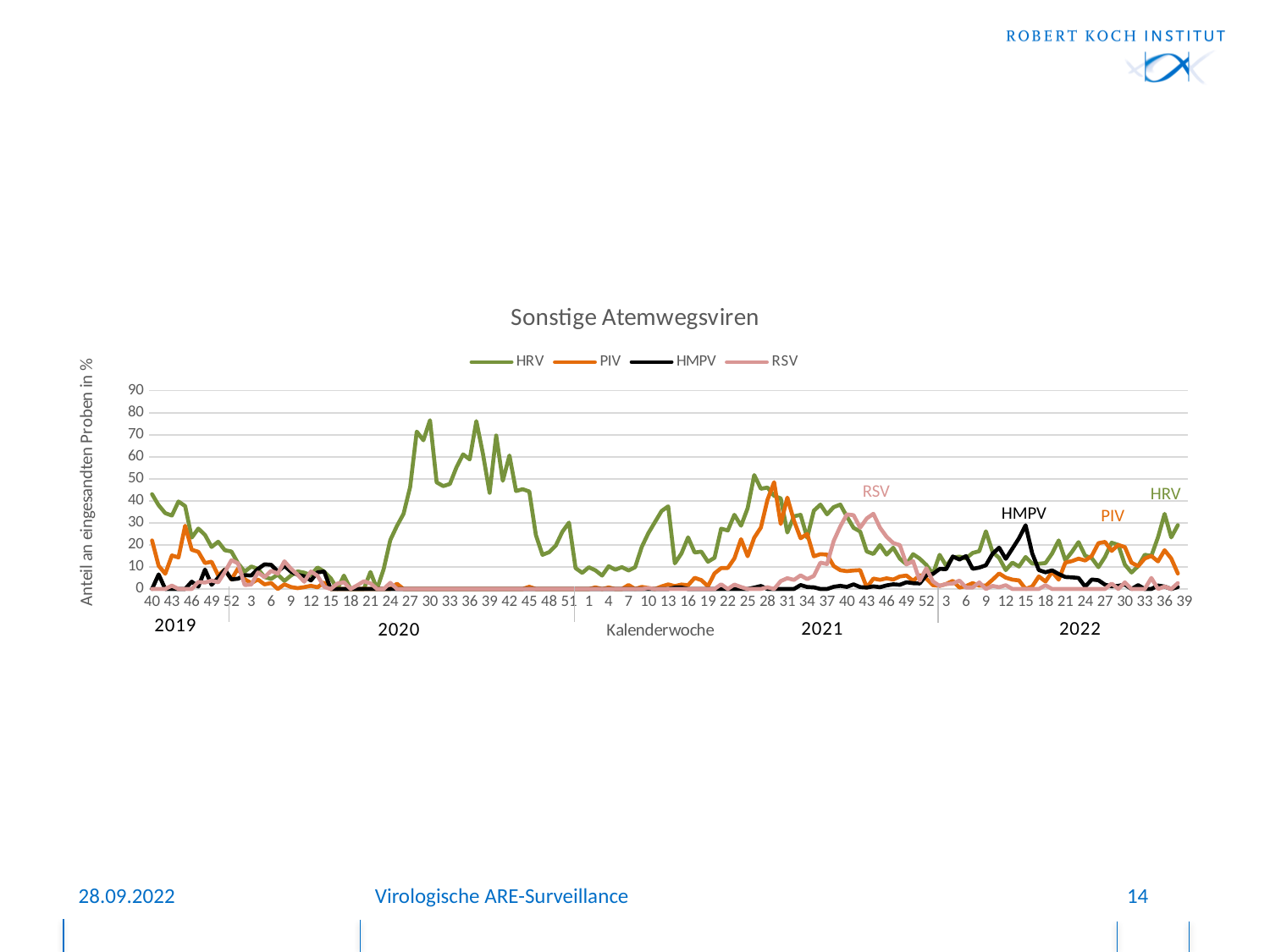
Is the highest value reached by RSV greater or less than 40? less Which series has the larger peak value, HRV or PIV? HRV Is the highest value reached by HMPV in 2022 greater or less than 20? greater Is the highest value reached by PIV in 2021 greater or less than 40? greater What is the title of the chart? Sonstige Atemwegsviren What is the label of the vertical axis of the chart? Anteil an eingesandten Proben in % Which series has the larger peak value, RSV or HRV? HRV Which series reaches the highest value anywhere in the chart? HRV How many years are marked along the x axis of the chart? 4 How many series does the legend of the chart list? 4 What kind of chart is shown on the slide? line chart